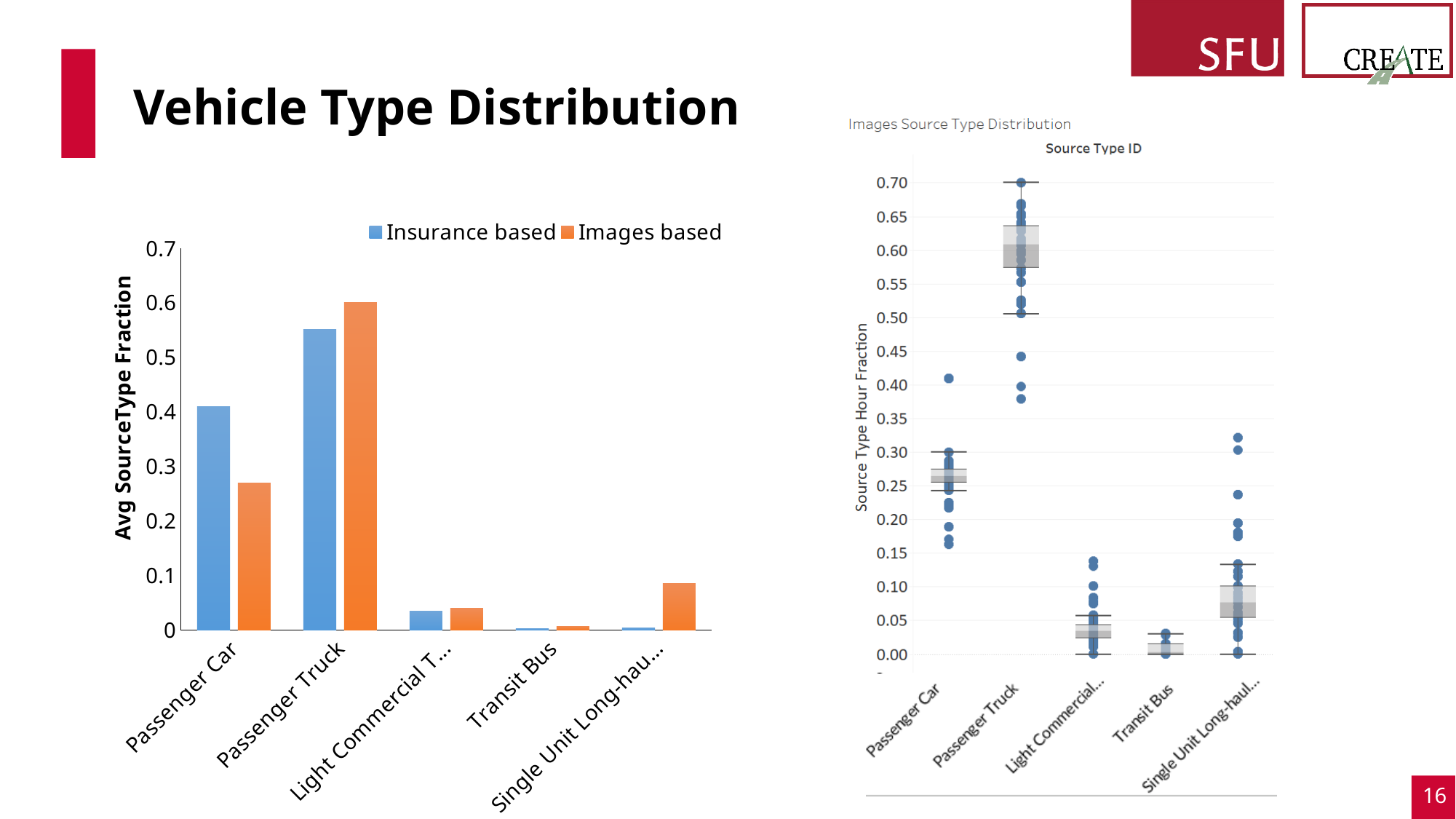
In the left bar chart, how many vehicle categories are shown on the x axis? 5 In the left bar chart, is the Images based value for Passenger Car greater or less than 0.3? less In the left bar chart, what colour represents the Images based series? orange In the right chart titled Images Source Type Distribution, which category has the highest Source Type Hour Fraction values? Passenger Truck In the left bar chart, is the Insurance based value for Passenger Car greater or less than 0.3? greater In the left bar chart, for Passenger Truck, which series has the larger value: Insurance based or Images based? Images based In the left bar chart, which category has the highest Images based value? Passenger Truck What kind of chart is the left chart showing Avg SourceType Fraction? bar chart In the left bar chart, how many series does the legend list? 2 In the left bar chart, for Passenger Car, which series has the larger value: Insurance based or Images based? Insurance based In the left bar chart, is the Images based value for Passenger Truck greater or less than 0.5? greater In the left bar chart, which category has the highest Insurance based value? Passenger Truck